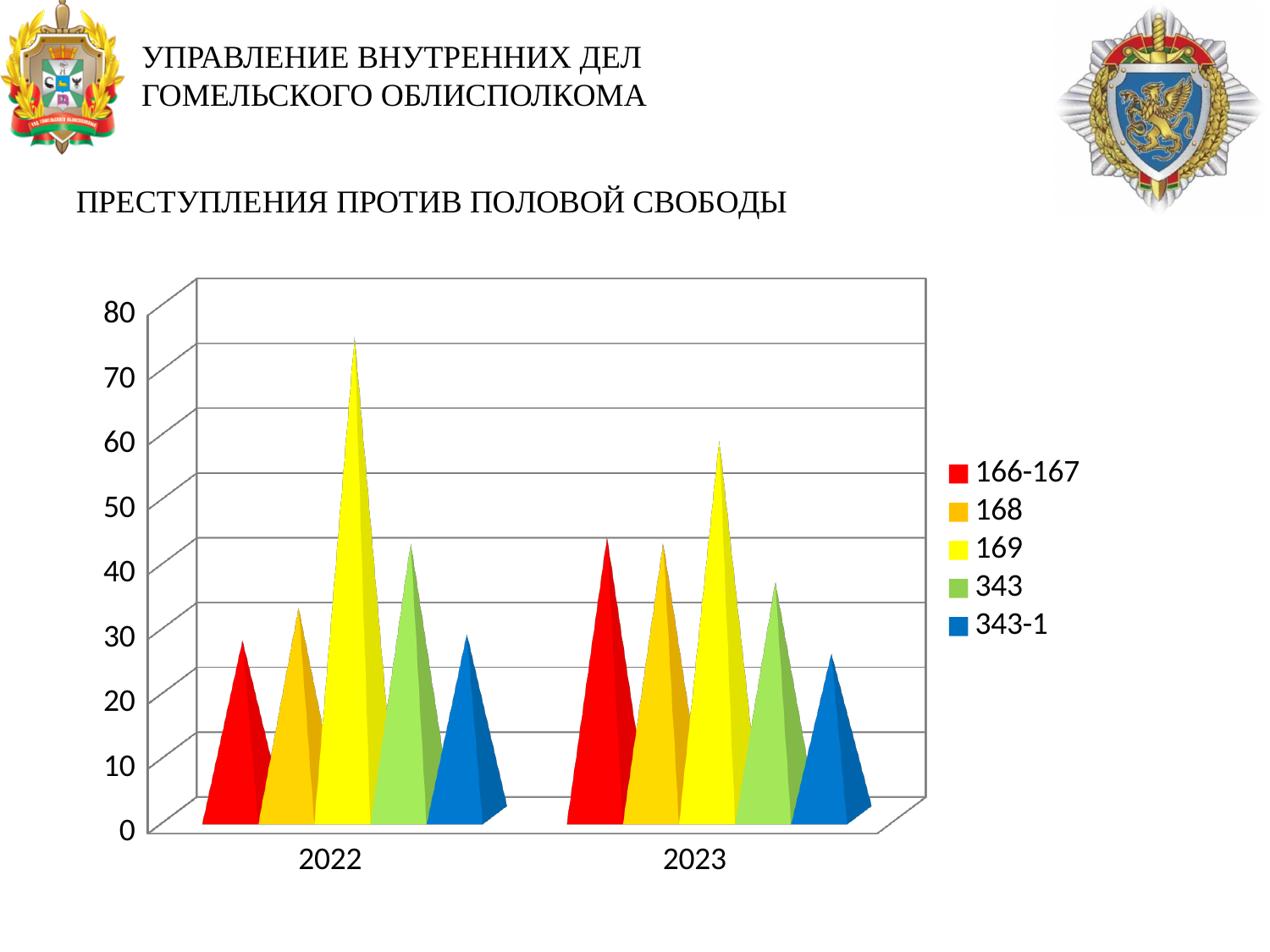
Which series has the highest value in 2023? 169 How many series does the legend list? 5 Which series has the lowest value in 2023? 343-1 Does the value for series 166-167 rise or fall from 2022 to 2023? rise What kind of chart is shown on the slide? bar chart Is the value for series 169 larger in 2022 or in 2023? 2022 Is the value for series 166-167 in 2022 greater or less than 40? less What colour represents series 169 in the legend? yellow Is the value for series 169 in 2022 greater or less than 60? greater How many categories (years) are shown on the x axis? 2 Which series has the highest value in 2022? 169 Is the value for series 169 in 2023 greater or less than 70? less